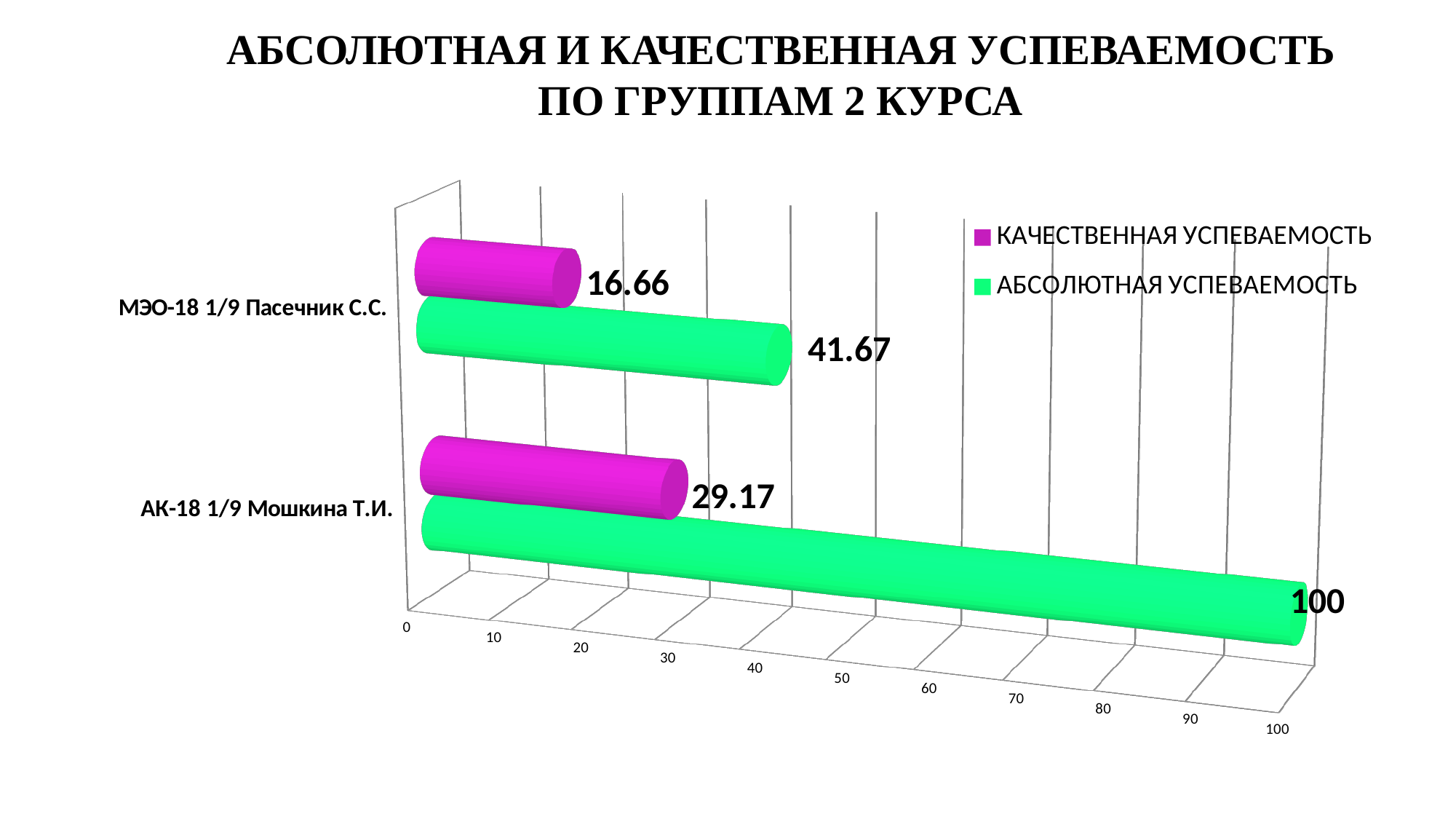
Which group has the highest АБСОЛЮТНАЯ УСПЕВАЕМОСТЬ? АК-18 1/9 Мошкина Т.И. How many series does the legend list? 2 What is the difference between the АБСОЛЮТНАЯ УСПЕВАЕМОСТЬ values of АК-18 1/9 Мошкина Т.И. and МЭО-18 1/9 Пасечник С.С.? 58.33 What is the КАЧЕСТВЕННАЯ УСПЕВАЕМОСТЬ value for МЭО-18 1/9 Пасечник С.С.? 16.66 What is the difference between the КАЧЕСТВЕННАЯ УСПЕВАЕМОСТЬ values of АК-18 1/9 Мошкина Т.И. and МЭО-18 1/9 Пасечник С.С.? 12.51 How many groups are shown on the chart? 2 What kind of chart is shown on the slide? Bar chart What is the КАЧЕСТВЕННАЯ УСПЕВАЕМОСТЬ value for АК-18 1/9 Мошкина Т.И.? 29.17 What is the АБСОЛЮТНАЯ УСПЕВАЕМОСТЬ value for АК-18 1/9 Мошкина Т.И.? 100 What is the АБСОЛЮТНАЯ УСПЕВАЕМОСТЬ value for МЭО-18 1/9 Пасечник С.С.? 41.67 Which group has the lowest КАЧЕСТВЕННАЯ УСПЕВАЕМОСТЬ? МЭО-18 1/9 Пасечник С.С. Which is larger: the КАЧЕСТВЕННАЯ УСПЕВАЕМОСТЬ for АК-18 1/9 Мошкина Т.И. or the АБСОЛЮТНАЯ УСПЕВАЕМОСТЬ for МЭО-18 1/9 Пасечник С.С.? АБСОЛЮТНАЯ УСПЕВАЕМОСТЬ for МЭО-18 1/9 Пасечник С.С.